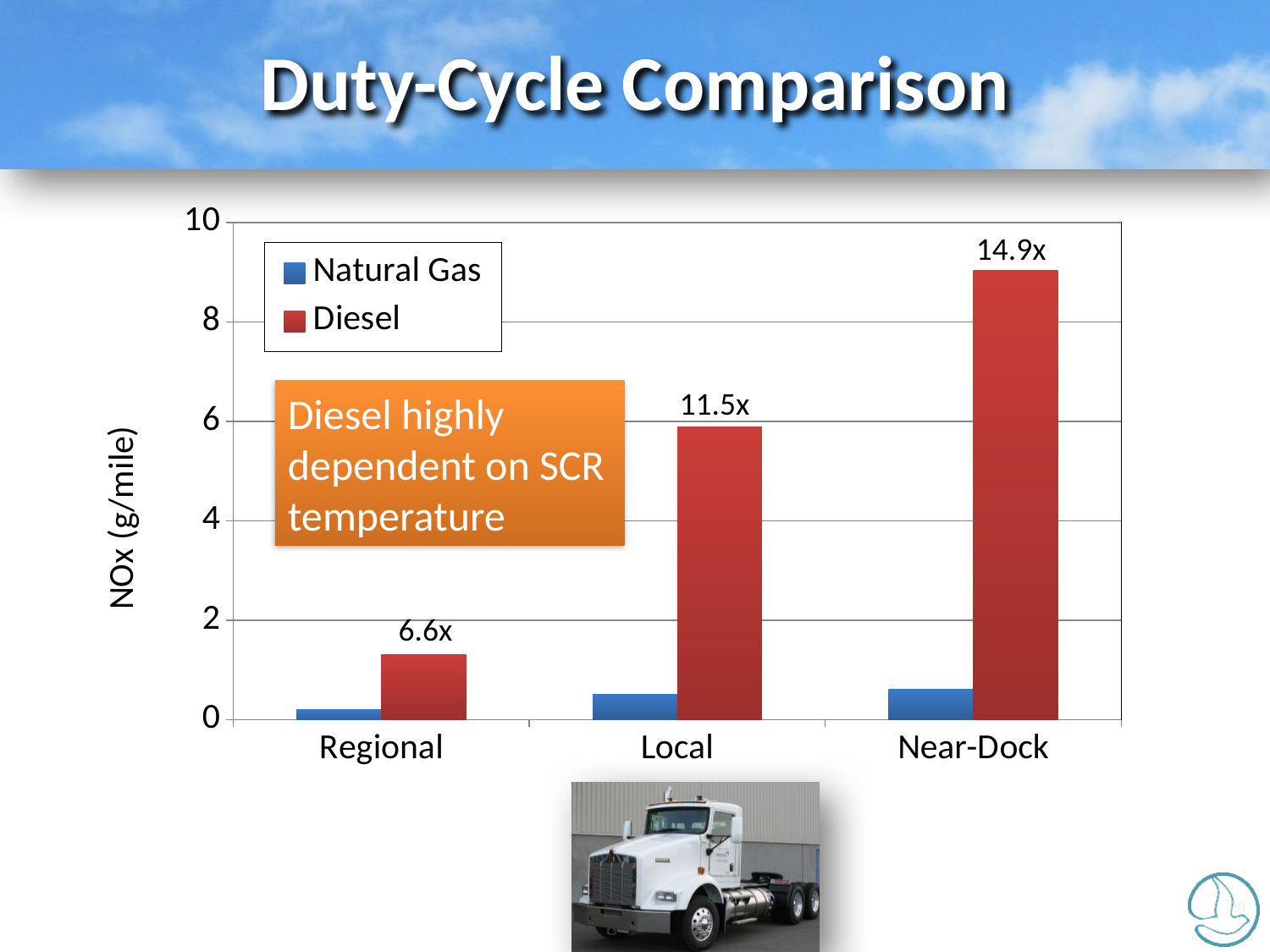
Is the Natural Gas value for Near-Dock greater or less than 2? less What kind of chart is shown on the slide? bar chart How many duty-cycle categories are shown on the x axis? 3 Which category has the highest Diesel NOx value? Near-Dock For the Local duty cycle, which is larger: the Natural Gas bar or the Diesel bar? Diesel How many series does the legend list? 2 Is the Diesel value for Regional greater or less than 2? less Which category has the lowest Diesel NOx value? Regional Do the Diesel values rise or fall moving from Regional to Local to Near-Dock? rise What label is printed above the Diesel bar for the Local duty cycle? 11.5x What is the label on the y axis of the chart? NOx (g/mile) Is the Diesel value for Near-Dock greater or less than 8? greater